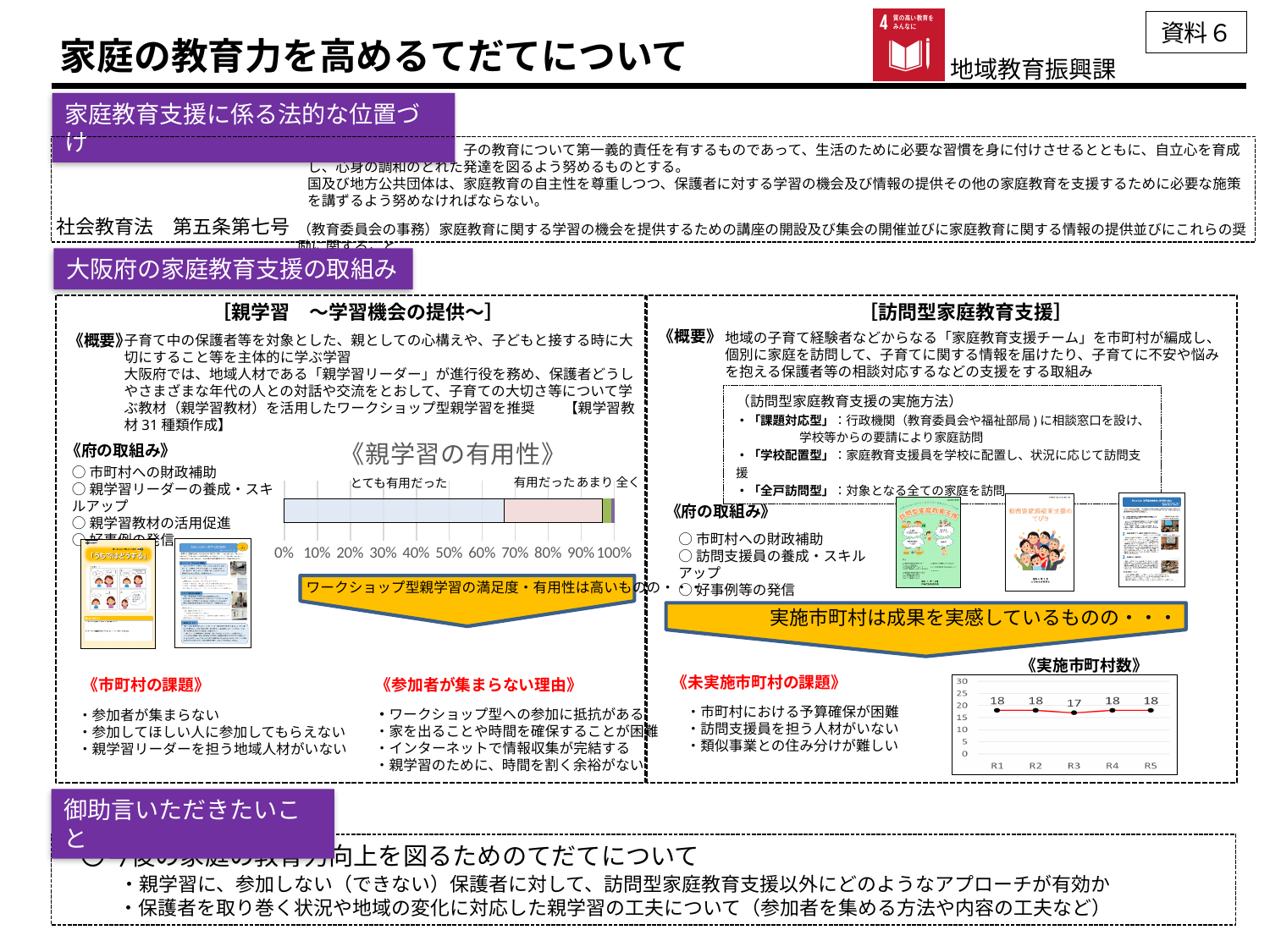
What kind of chart is the 《親学習の有用性》 chart? bar chart How many response categories are shown in the 《親学習の有用性》 chart? 4 What kind of chart is the 《実施市町村数》 chart? line chart How many data points are plotted in the 《実施市町村数》 chart? 5 In the 《実施市町村数》 chart, which is larger, the value for R2 or the value for R3? R2 In the 《実施市町村数》 chart, what is the value for R1? 18 In the 《実施市町村数》 chart, what is the difference between the values for R2 and R3? 1 In the 《実施市町村数》 chart, what is the value for R3? 17 In the 《実施市町村数》 chart, what is the value for R5? 18 In the 《実施市町村数》 chart, is the value for R3 greater or less than 15? greater In the 《実施市町村数》 chart, which year has the lowest value? R3 In the 《親学習の有用性》 chart, is the share for とても有用だった greater or less than 60%? greater